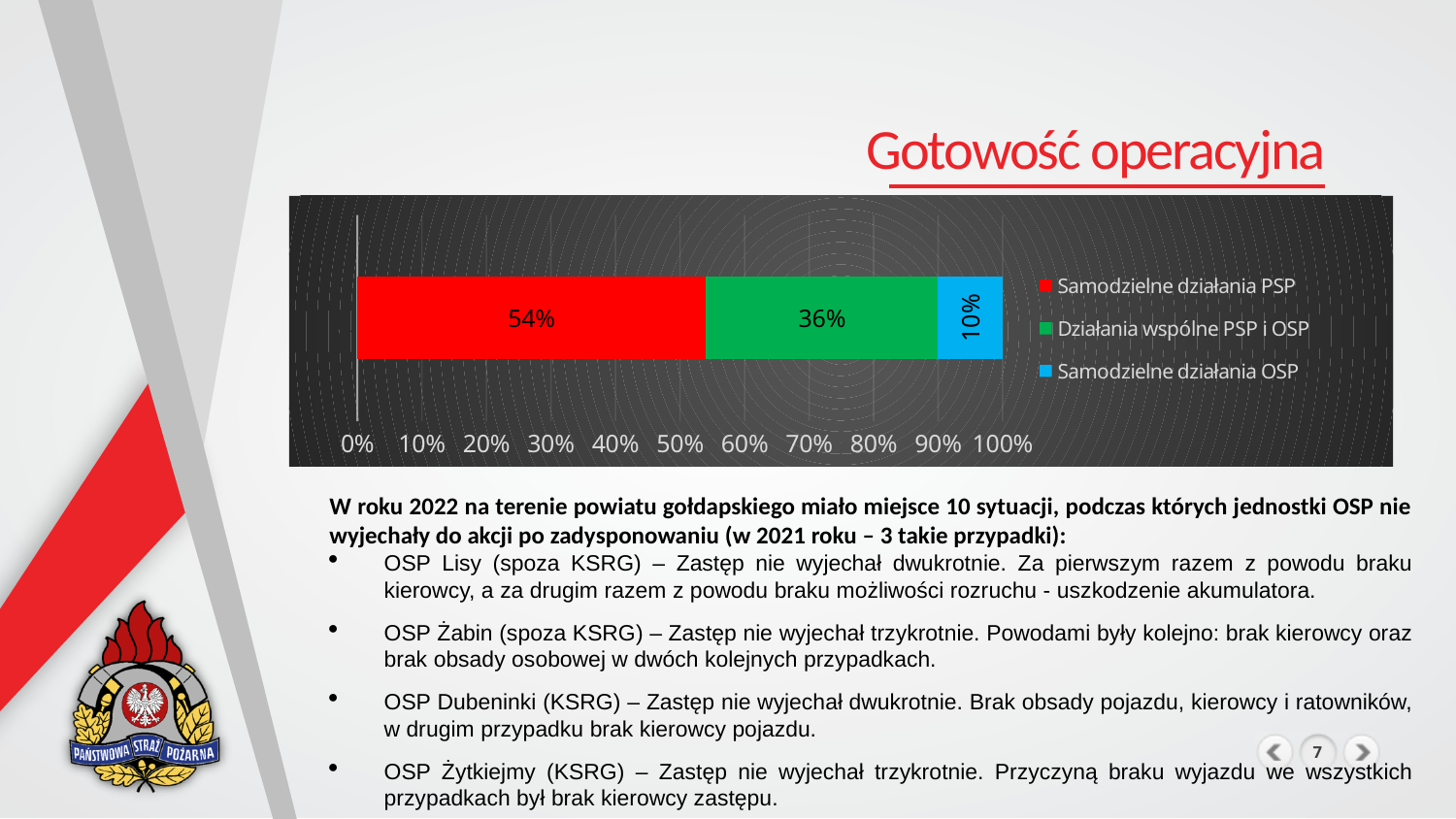
What value is shown for Samodzielne działania OSP? 10% What is the difference between the Samodzielne działania PSP segment and the Działania wspólne PSP i OSP segment? 18% What value is shown for Działania wspólne PSP i OSP? 36% What is the total of the three segments in the stacked bar? 100% Which series has the largest segment in the bar? Samodzielne działania PSP Which is larger: the Działania wspólne PSP i OSP segment or the Samodzielne działania OSP segment? Działania wspólne PSP i OSP What colour is the Samodzielne działania OSP segment? Blue Which series has the smallest segment in the bar? Samodzielne działania OSP Is the value for Samodzielne działania PSP greater or less than 50%? greater What kind of chart is shown on the slide? Stacked bar chart What share of the bar is labelled for Samodzielne działania PSP? 54% How many series does the legend list? 3